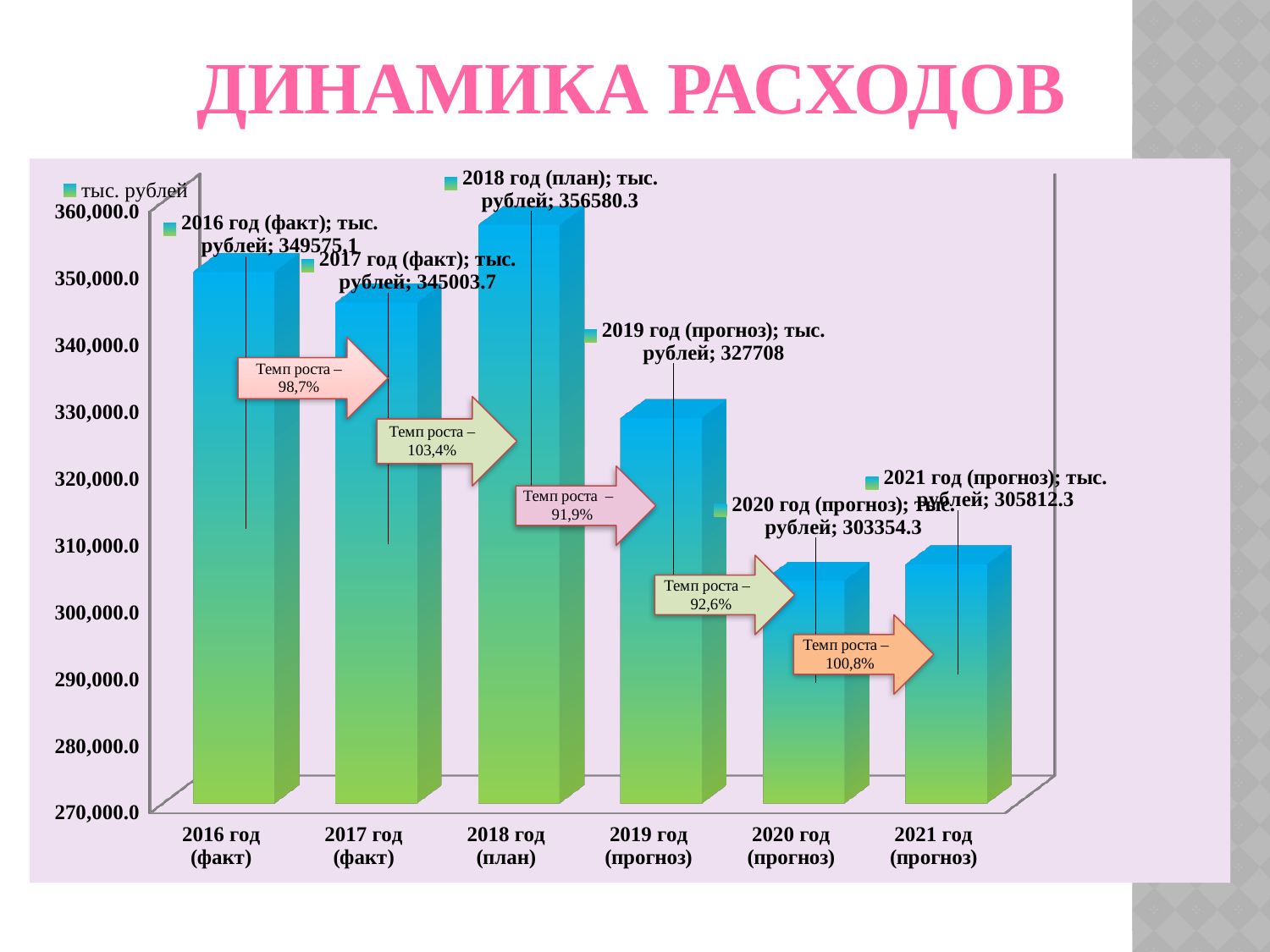
Which is larger, the value for 2016 год (факт) or 2017 год (факт)? 2016 год (факт) Which category has the highest value? 2018 год (план) Which category has the lowest value? 2020 год (прогноз) What is the value for 2018 год (план)? 356580.3 What kind of chart is shown on the slide? bar chart What is the value for 2016 год (факт)? 349575.1 What is the value for 2020 год (прогноз)? 303354.3 Do the values generally rise or fall from 2018 год (план) to 2020 год (прогноз)? fall Is the value for 2019 год (прогноз) greater or less than 330,000.0? less How many categories are shown on the x axis? 6 What is the title of the slide? ДИНАМИКА РАСХОДОВ What is the difference between the values for 2018 год (план) and 2019 год (прогноз)? 28872.3